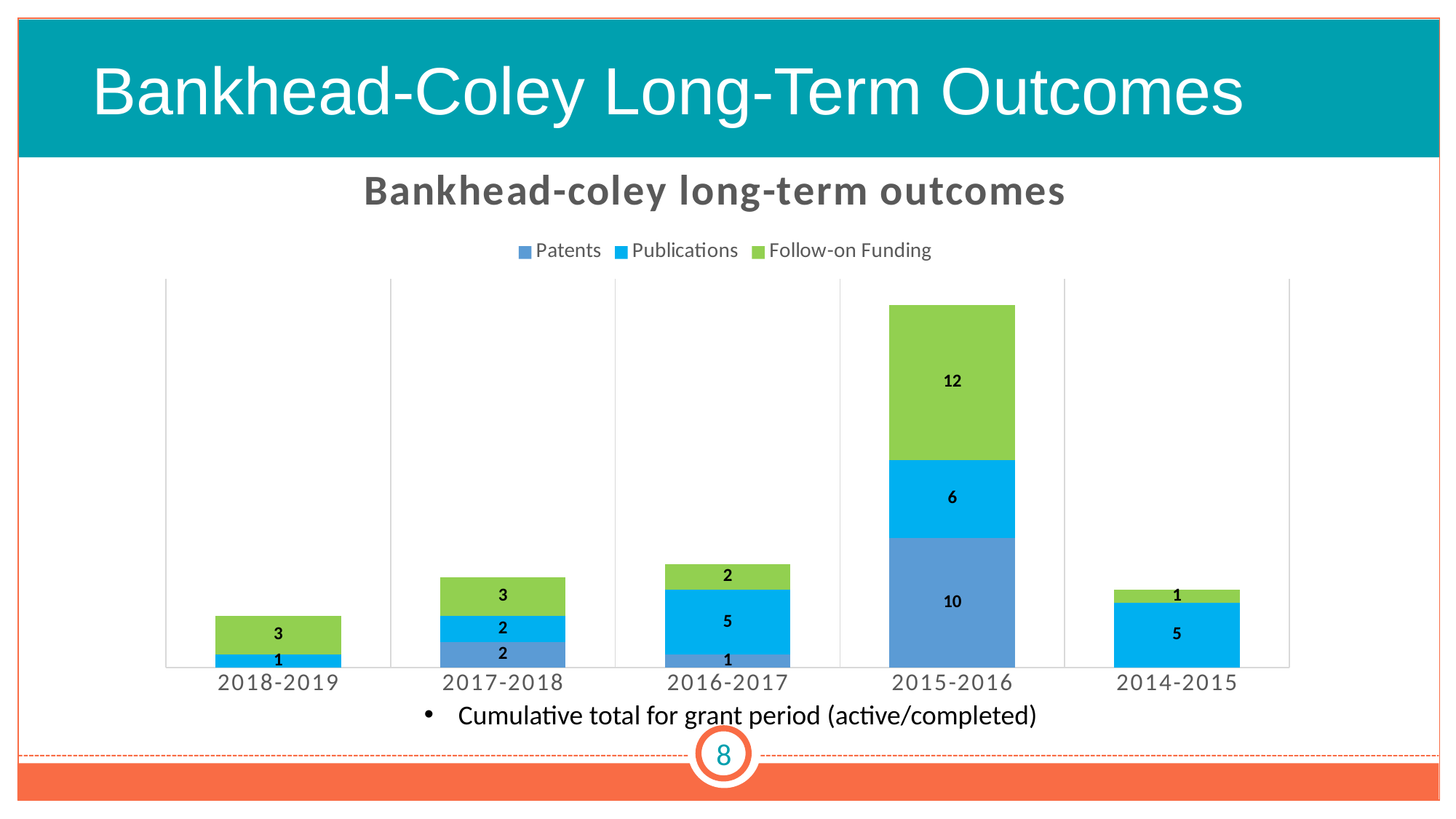
Which is larger, the Follow-on Funding value for 2017-2018 or for 2014-2015? 2017-2018 Which grant period has the tallest stacked bar? 2015-2016 What is the Patents value for 2015-2016? 10 What is the difference between the Publications values for 2015-2016 and 2016-2017? 1 What is the total of the stacked bar for 2015-2016? 28 What type of chart is shown on the slide? Stacked bar chart How many grant periods are shown on the x axis? 5 What is the total of the stacked bar for 2017-2018? 7 What is the Publications value for 2014-2015? 5 How many series does the legend list? 3 What is the Follow-on Funding value for 2018-2019? 3 What is the Follow-on Funding value for 2015-2016? 12